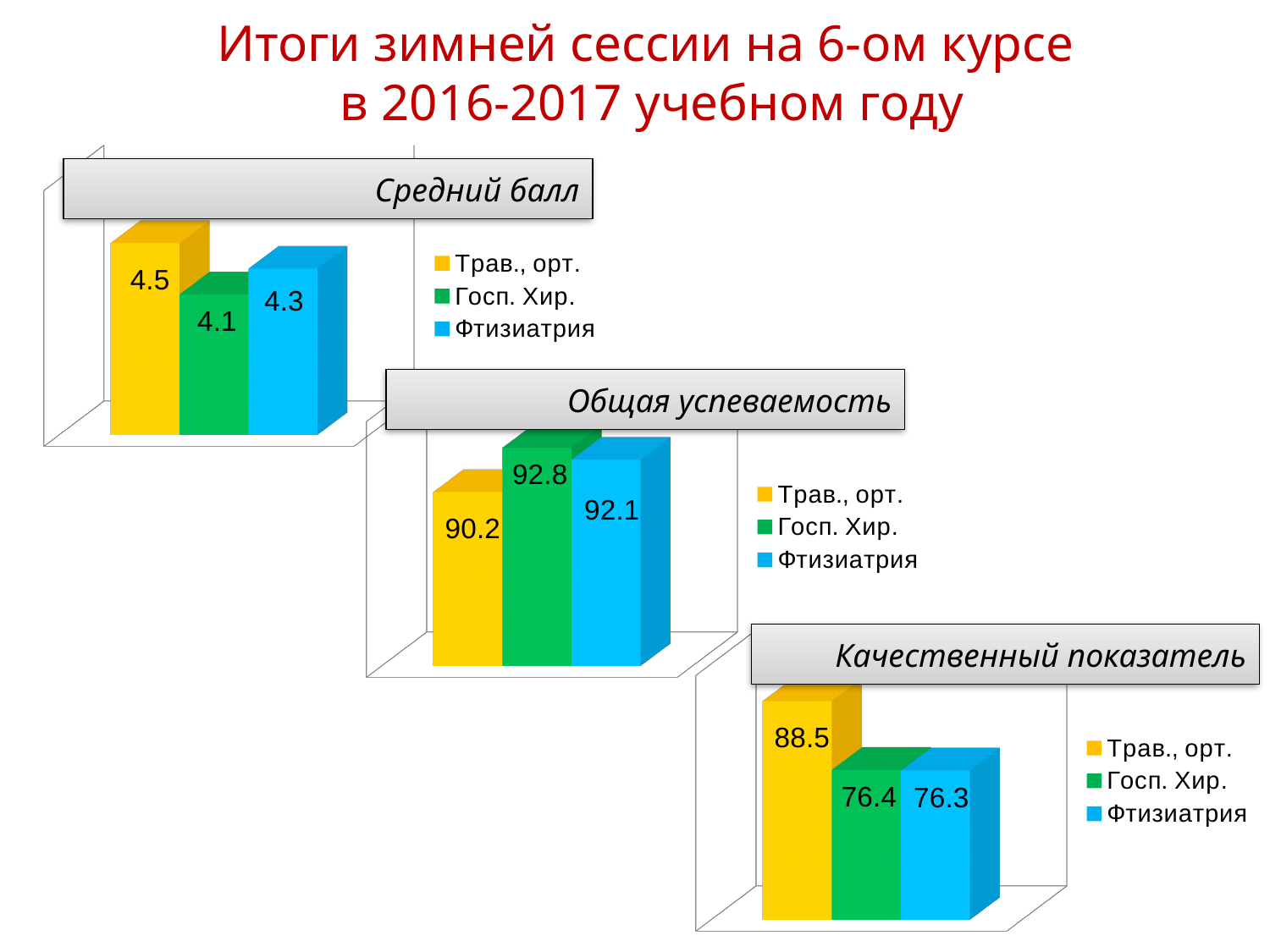
In the 'Общая успеваемость' chart, what is the difference between Госп. Хир. and Трав., орт.? 2.6 In the 'Общая успеваемость' chart, which series has the highest value? Госп. Хир. In the 'Средний балл' chart, which series has the lowest value? Госп. Хир. What kind of chart is the 'Качественный показатель' chart? Bar chart In the 'Качественный показатель' chart, what is the difference between Трав., орт. and Госп. Хир.? 12.1 In the 'Средний балл' chart, what is the value for Трав., орт.? 4.5 In the 'Качественный показатель' chart, what is the value for Фтизиатрия? 76.3 In the 'Общая успеваемость' chart, what is the value for Госп. Хир.? 92.8 In the 'Качественный показатель' chart, which series has the highest value? Трав., орт. In the 'Средний балл' chart, what is the difference between Трав., орт. and Фтизиатрия? 0.2 How many series does the legend of the 'Средний балл' chart list? 3 In the 'Общая успеваемость' chart, which is larger: Трав., орт. or Фтизиатрия? Фтизиатрия